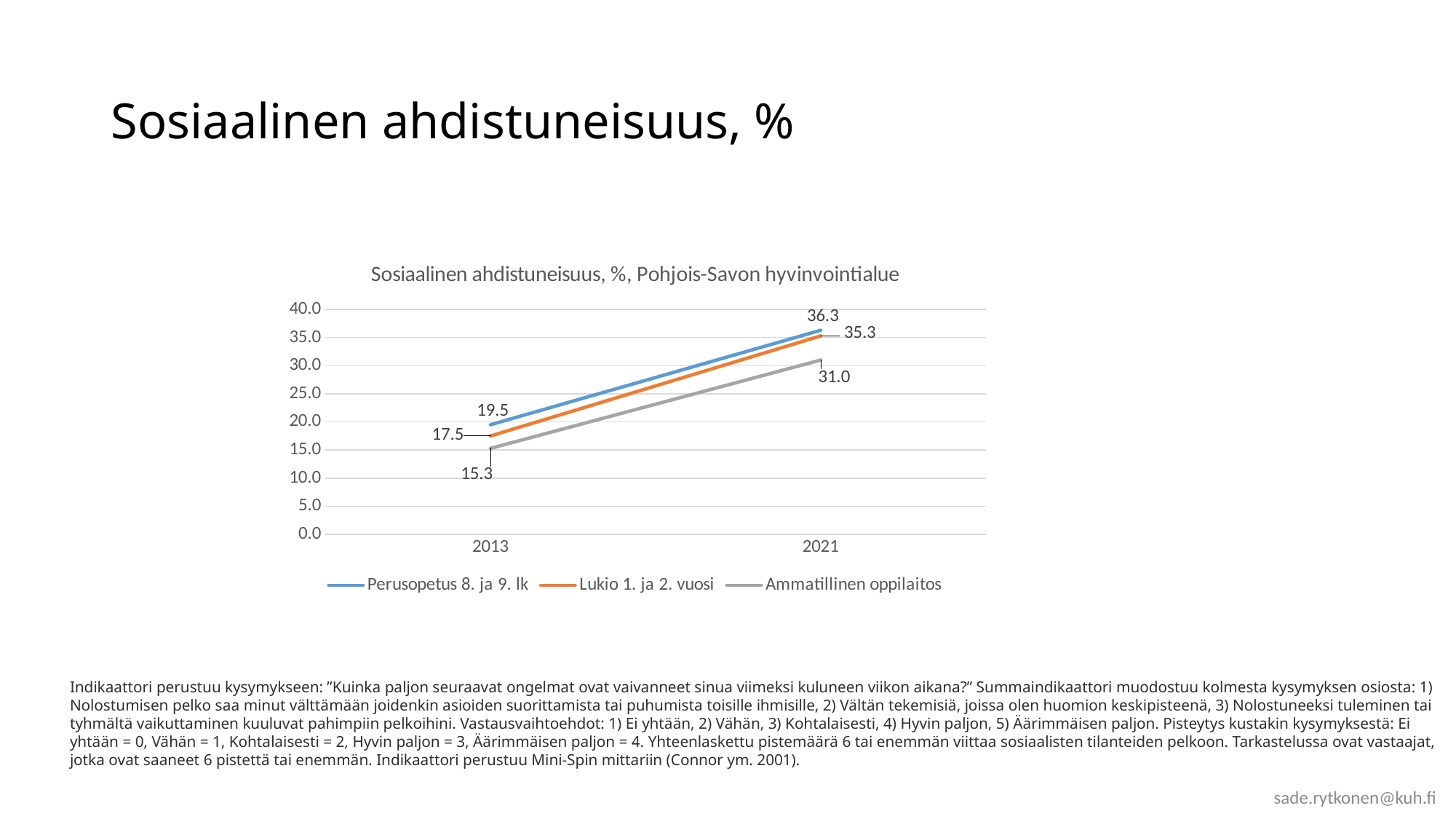
Do the values for Perusopetus 8. ja 9. lk rise or fall from 2013 to 2021? rise Which series has the lowest value in 2013? Ammatillinen oppilaitos What is the value for Perusopetus 8. ja 9. lk in 2021? 36.3 Which is larger in 2021: Lukio 1. ja 2. vuosi or Ammatillinen oppilaitos? Lukio 1. ja 2. vuosi What is the value for Lukio 1. ja 2. vuosi in 2013? 17.5 What kind of chart is shown on the slide? line chart What is the value for Ammatillinen oppilaitos in 2021? 31.0 How many years are shown on the x axis? 2 What is the difference between Perusopetus 8. ja 9. lk and Lukio 1. ja 2. vuosi in 2013? 2.0 Which series has the highest value in 2021? Perusopetus 8. ja 9. lk How many series does the legend list? 3 What is the difference between the 2021 and 2013 values for Ammatillinen oppilaitos? 15.7